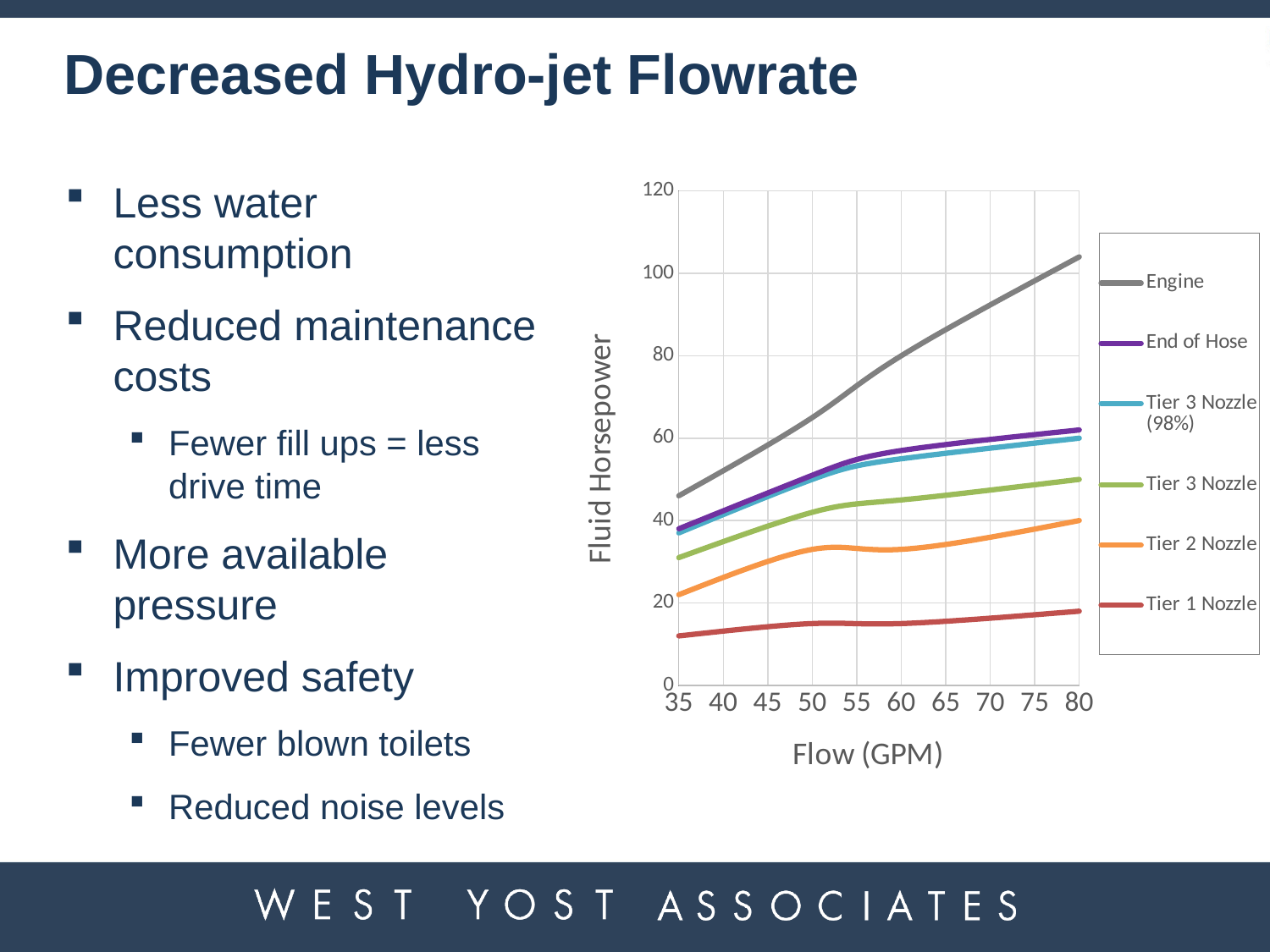
What is the title of the chart's x axis? Flow (GPM) At 60 GPM, which is larger: Tier 3 Nozzle or Tier 2 Nozzle? Tier 3 Nozzle Does the Engine series rise or fall as flow increases from 35 to 80 GPM? Rises How many flow values are marked along the x axis of the chart? 10 Is the Tier 1 Nozzle value at 35 GPM greater or less than 20? less Is the Engine value at 80 GPM greater or less than 100? greater Is the Tier 3 Nozzle value at 80 GPM greater or less than 40? greater What is the title of the chart's y axis? Fluid Horsepower Which series has the highest fluid horsepower at 80 GPM? Engine How many series does the chart's legend list? 6 Which series has the lowest fluid horsepower at 80 GPM? Tier 1 Nozzle What kind of chart is shown on the slide? Line chart